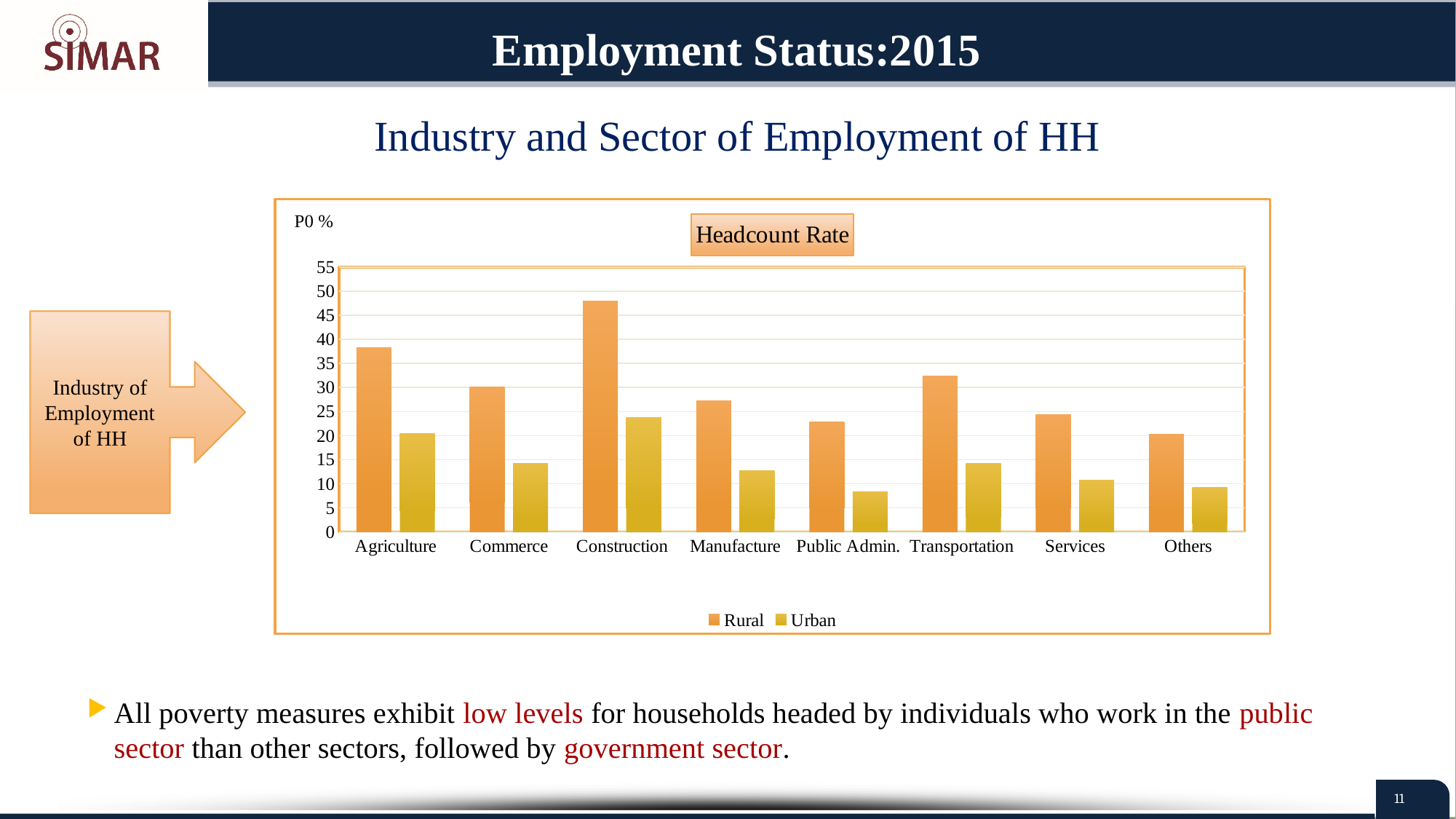
How many series does the legend list? 2 Is the Urban value for Public Admin. greater or less than 10? less What is the title shown above the chart's plot area? Headcount Rate Is the Rural value for Construction greater or less than 45? greater Is the Rural value for Transportation greater or less than 30? greater What kind of chart is shown on the slide? bar chart Which industry has the lowest Rural headcount rate? Others Which industry has the highest Rural headcount rate? Construction How many industry categories are shown on the x axis? 8 Which is larger, the Rural value for Agriculture or the Rural value for Commerce? Agriculture Which industry has the highest Urban headcount rate? Construction